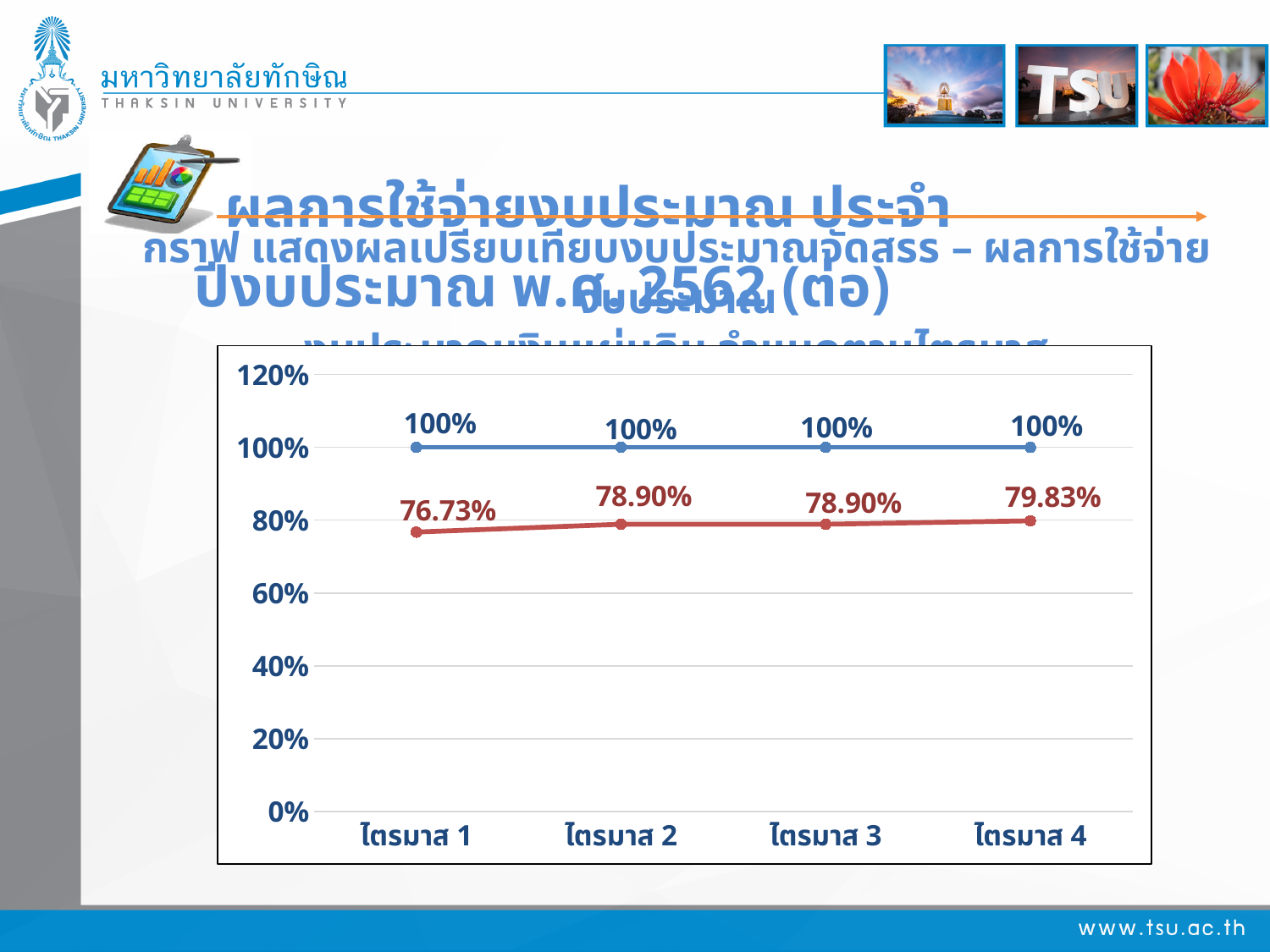
What is the value of the red line for ไตรมาส 1? 76.73% What is the value of the blue line for ไตรมาส 3? 100% Which is larger for ไตรมาส 2, the blue line value or the red line value? the blue line value What kind of chart is shown on the slide? line chart In which quarter is the red line at its highest value? ไตรมาส 4 What is the difference between the red line values for ไตรมาส 4 and ไตรมาส 1? 3.10% What is the difference between the blue line and the red line for ไตรมาส 4? 20.17% In which quarter is the red line at its lowest value? ไตรมาส 1 How many quarters (categories) are shown on the x axis of the chart? 4 What is the value of the red line for ไตรมาส 4? 79.83% What is the value of the red line for ไตรมาส 2? 78.90% Does the red line rise or fall from ไตรมาส 1 to ไตรมาส 4? rise